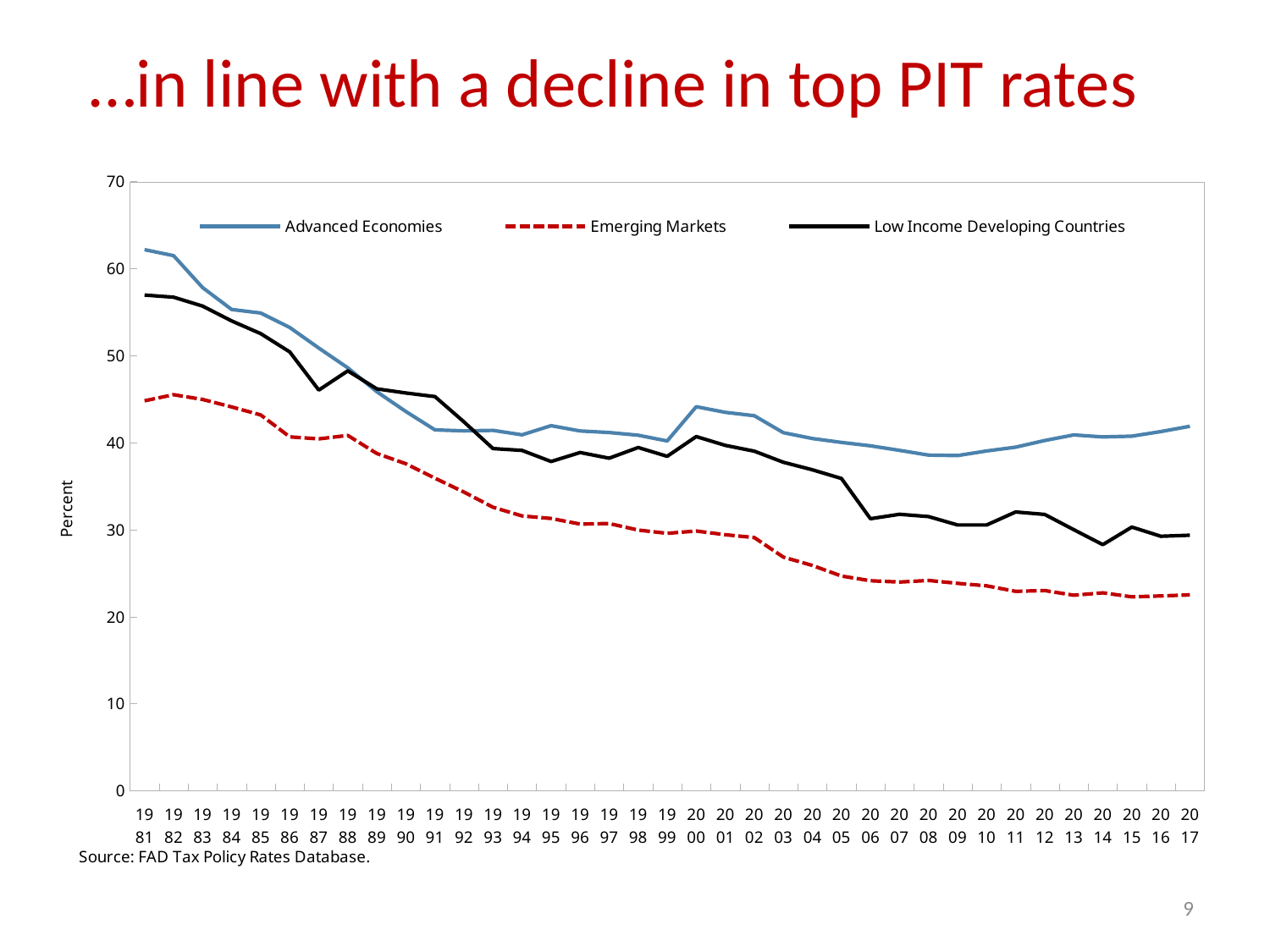
What kind of chart is shown on the slide? Line chart In 2017, which is larger: Advanced Economies or Emerging Markets? Advanced Economies Does the Emerging Markets line generally rise or fall from 1981 to 2017? Fall Is the value for Advanced Economies in 1981 greater or less than 60? greater Which series has the lowest value in 1981? Emerging Markets How many years are shown along the x axis? 37 Is the value for Emerging Markets in 2017 greater or less than 30? less Is the value for Advanced Economies in 2017 greater or less than 40? greater What is the label on the y axis? Percent How many series does the legend list? 3 Which series has the highest value in 2017? Advanced Economies